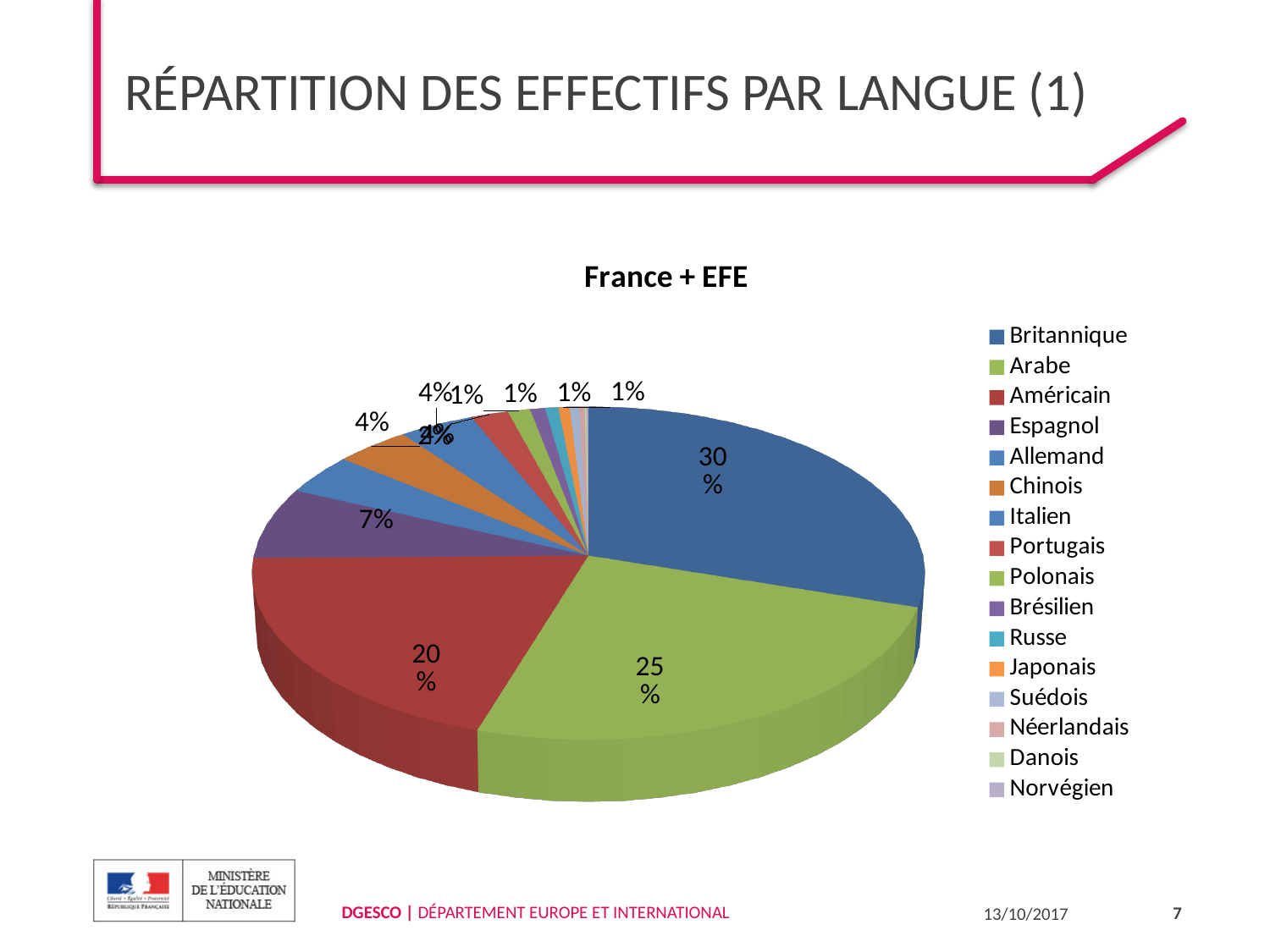
What share of the pie does Allemand represent? 4% What share of the pie does Espagnol represent? 7% What is the difference in percentage points between the Britannique share and the Arabe share? 5 How many languages are listed in the legend? 16 What kind of chart is shown on the slide? pie chart Which language has the largest share of the pie? Britannique Is the share for Espagnol greater or less than 10%? less What share of the pie does Américain represent? 20% What is the title of the chart? France + EFE Which has the larger share, Arabe or Américain? Arabe